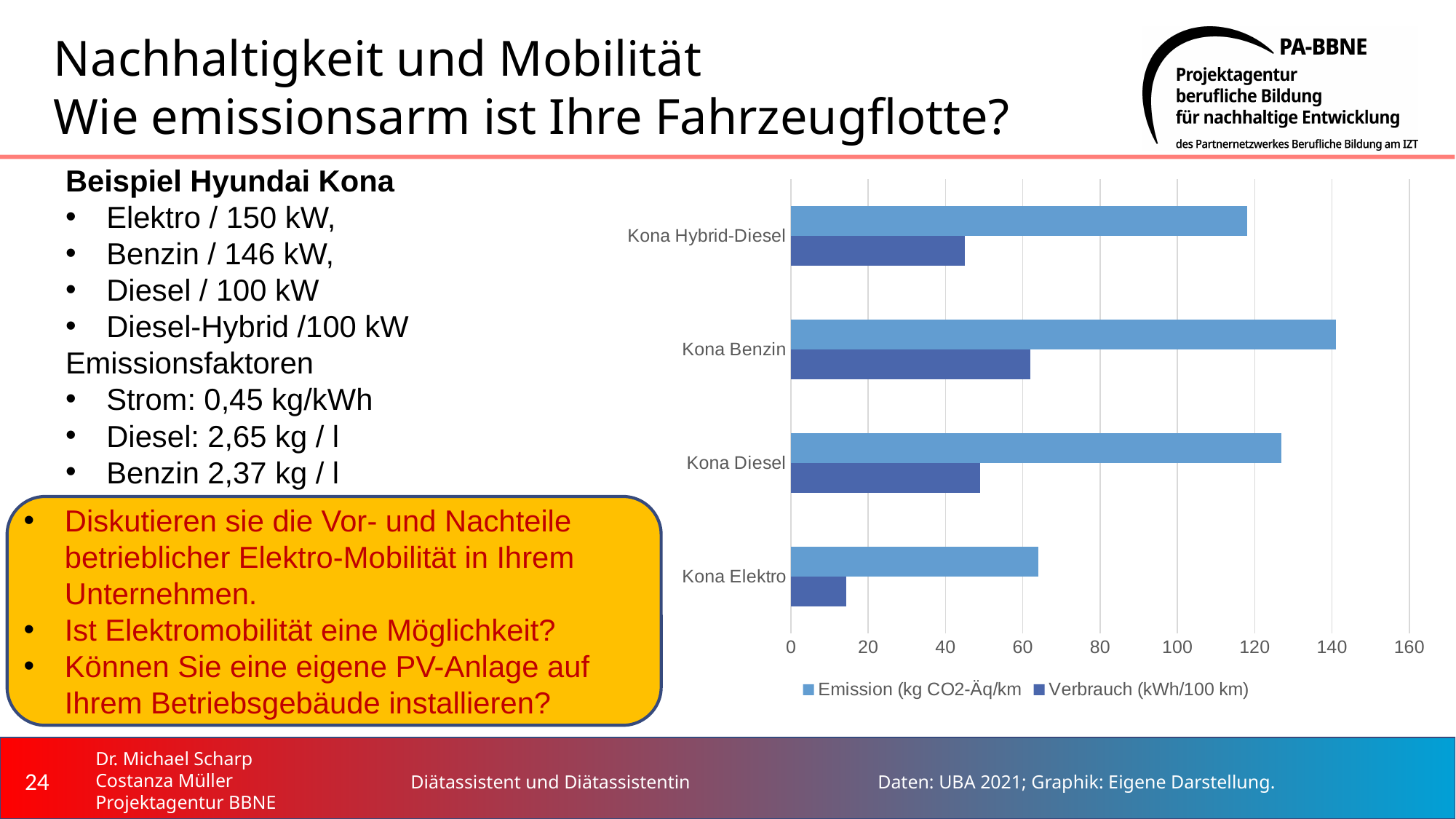
Which vehicle has the lowest Emission (kg CO2-Äq/km) value? Kona Elektro What kind of chart is shown on the slide? bar chart Which vehicle has the highest Verbrauch (kWh/100 km) value? Kona Benzin Which vehicle has the highest Emission (kg CO2-Äq/km) value? Kona Benzin Which vehicle has the lowest Verbrauch (kWh/100 km) value? Kona Elektro Is the Verbrauch value for Kona Elektro greater or less than 20? less What are the two series named in the chart legend? Emission (kg CO2-Äq/km) and Verbrauch (kWh/100 km) Is the Emission value for Kona Elektro greater or less than 80? less How many vehicle categories are shown on the chart? 4 How many series does the chart legend list? 2 Which is larger, the Emission value for Kona Diesel or for Kona Hybrid-Diesel? Kona Diesel